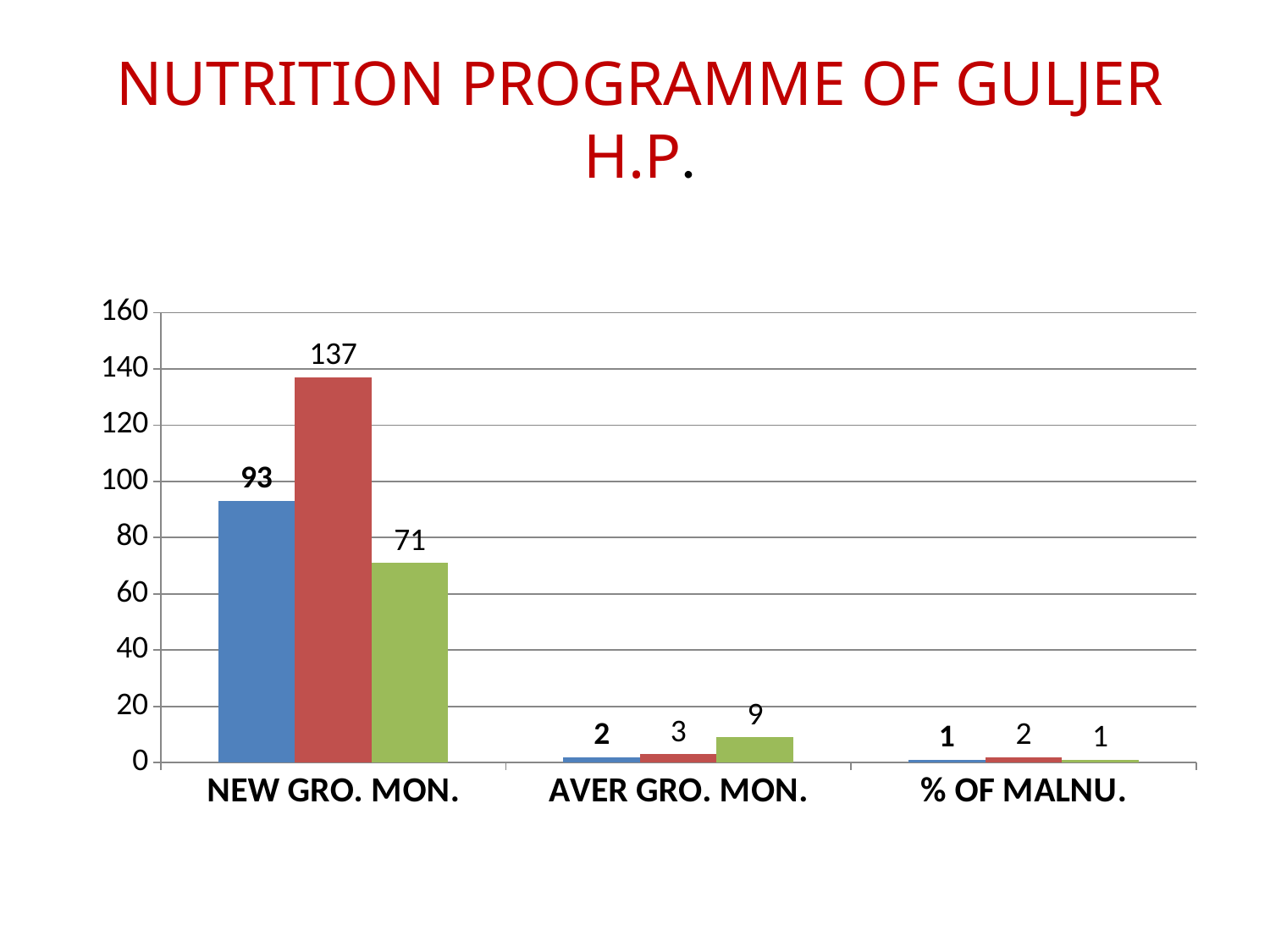
What is the value of the red bar for % OF MALNU.? 2 What kind of chart is shown on the slide? bar chart Which category has the highest bar on the chart? NEW GRO. MON. What is the value of the blue bar for NEW GRO. MON.? 93 Which is larger for NEW GRO. MON., the blue bar or the green bar? the blue bar Is the value of the red bar for NEW GRO. MON. greater or less than 120? greater How many categories are shown on the x axis? 3 What is the title of the slide containing the chart? NUTRITION PROGRAMME OF GULJER H.P. What is the difference between the red bar and the green bar for NEW GRO. MON.? 66 What is the value of the red bar for NEW GRO. MON.? 137 What is the value of the green bar for AVER GRO. MON.? 9 What is the difference between the blue bar and the green bar for AVER GRO. MON.? 7